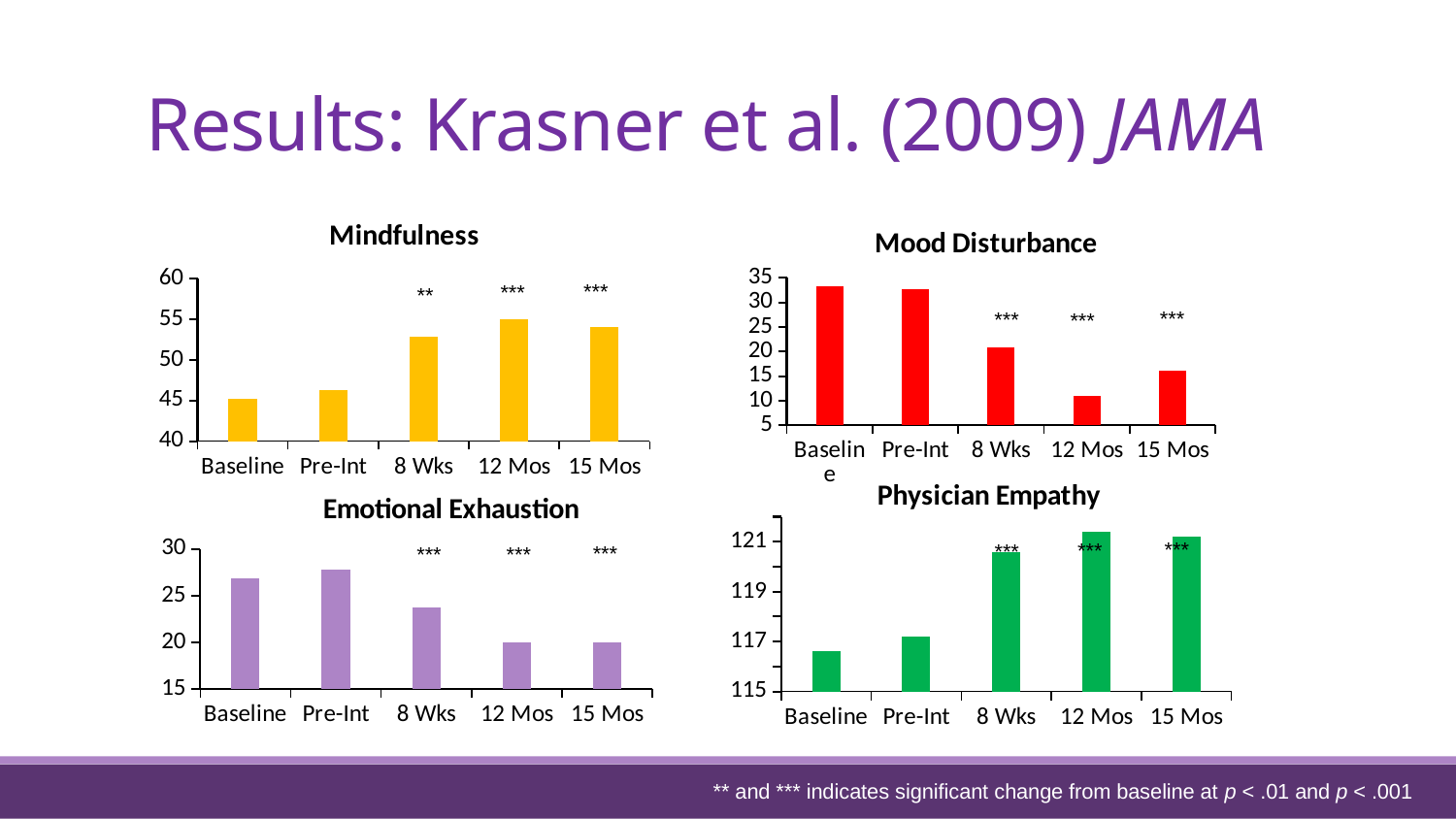
In the Physician Empathy chart, is the value for Baseline greater or less than 117? less In the Mood Disturbance chart, which category has the lowest value? 12 Mos How many categories are shown on the x axis of the Mood Disturbance chart? 5 In the Emotional Exhaustion chart, is the value for 8 Wks greater or less than 25? less In the Physician Empathy chart, which is larger, the value for Baseline or the value for 8 Wks? 8 Wks In the Emotional Exhaustion chart, which is larger, the value for Pre-Int or the value for 12 Mos? Pre-Int In the Mood Disturbance chart, is the value for Baseline greater or less than 30? greater What kind of chart is the Mindfulness chart? bar chart In the Mood Disturbance chart, which is larger, the value for 12 Mos or the value for 15 Mos? 15 Mos What colour are the bars in the Mood Disturbance chart? red